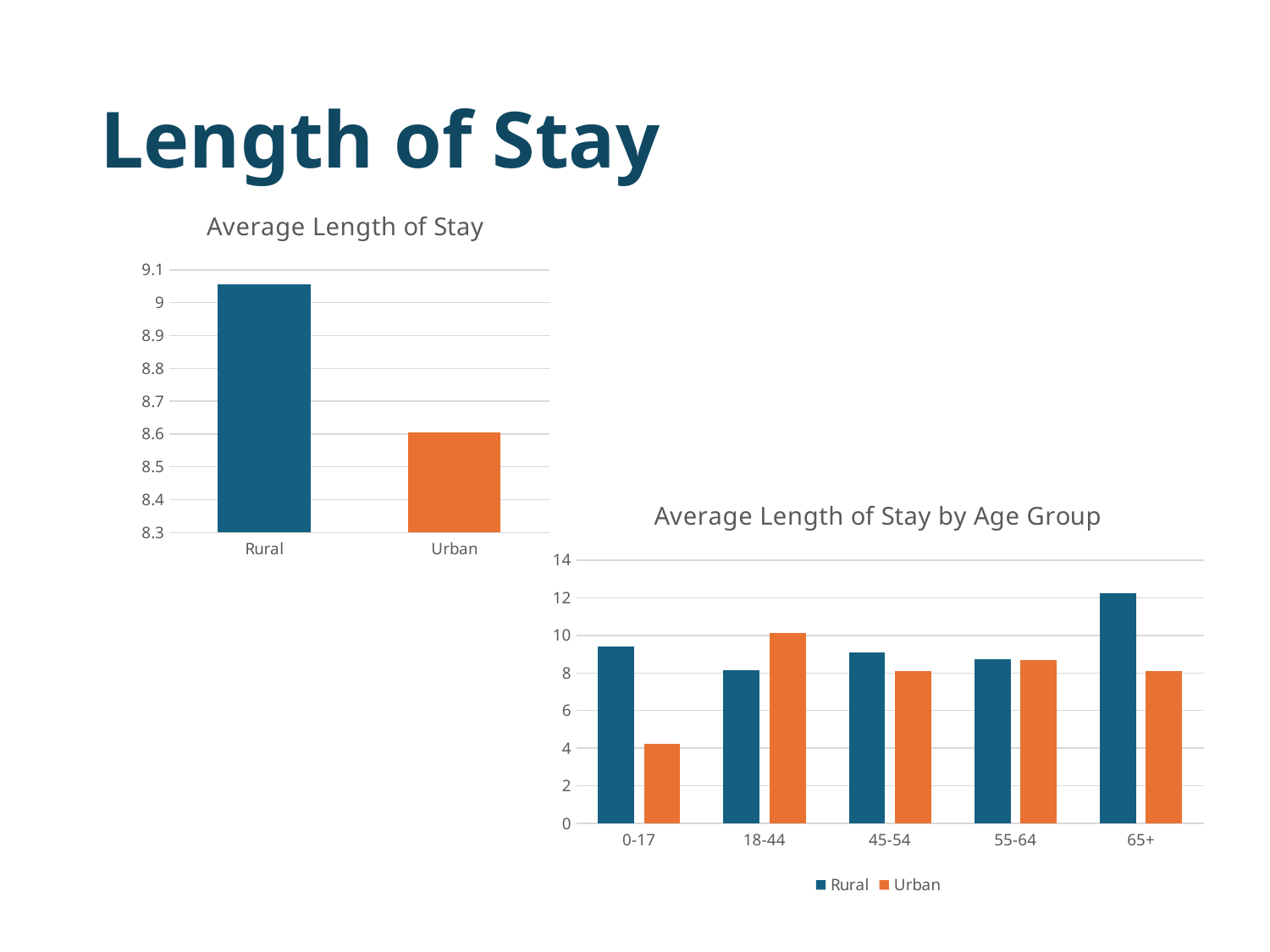
In the 'Average Length of Stay by Age Group' chart, which colour represents the Urban series? orange In the 'Average Length of Stay' chart, which category has the higher value, Rural or Urban? Rural In the 'Average Length of Stay by Age Group' chart, which age group has the highest Rural value? 65+ In the 'Average Length of Stay' chart, is the value for Urban greater or less than 8.7? less In the 'Average Length of Stay by Age Group' chart, which age group has the lowest Urban value? 0-17 What kind of chart is the 'Average Length of Stay' chart? bar chart In the 'Average Length of Stay by Age Group' chart, is the Urban value for 0-17 greater or less than 6? less In the 'Average Length of Stay' chart, is the value for Rural greater or less than 9? greater How many age groups are shown on the x axis of the 'Average Length of Stay by Age Group' chart? 5 How many series does the legend of the 'Average Length of Stay by Age Group' chart list? 2 In the 'Average Length of Stay by Age Group' chart, which is larger for the 18-44 age group, Rural or Urban? Urban How many categories are shown in the 'Average Length of Stay' chart? 2